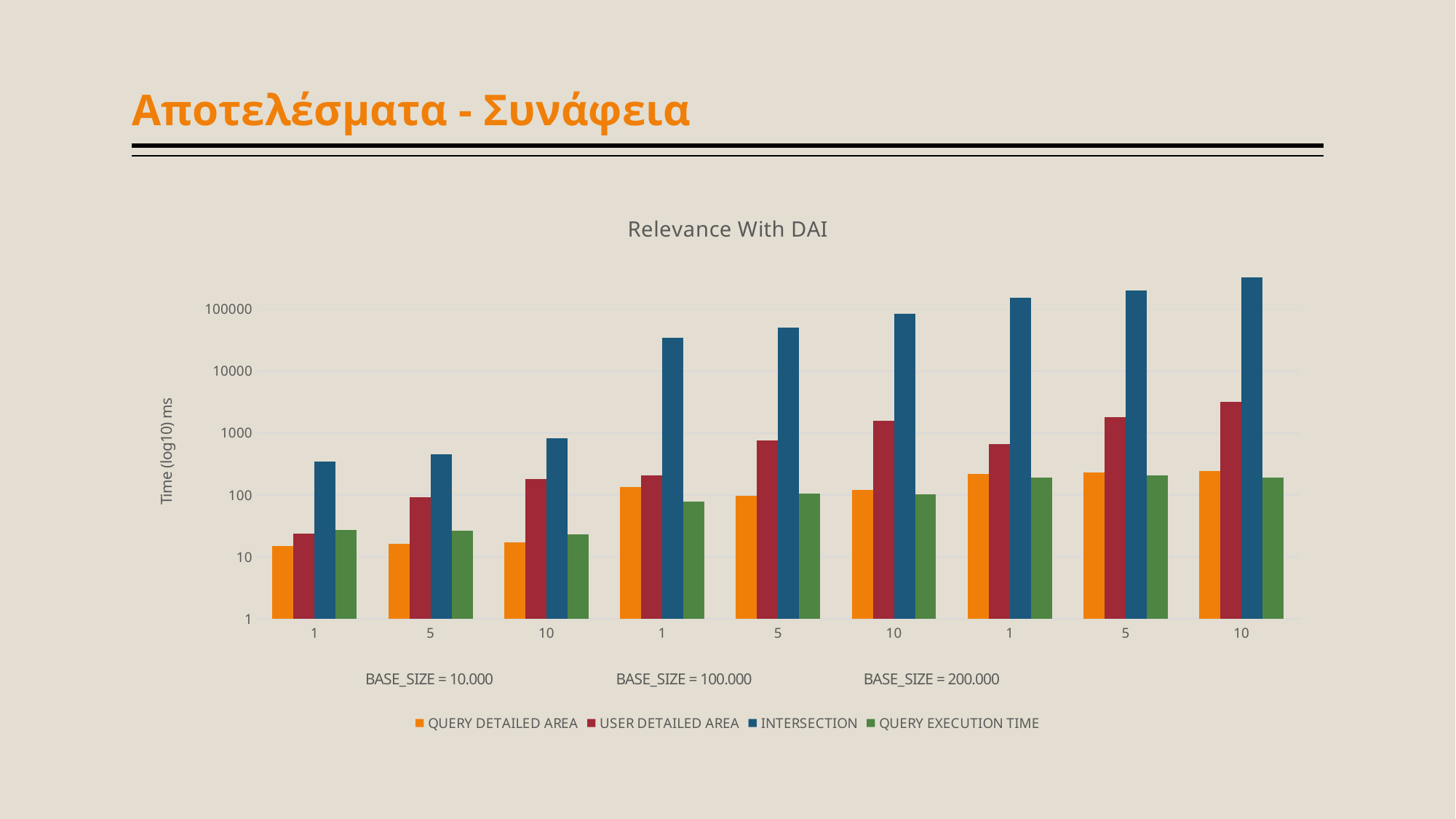
Is the value for USER DETAILED AREA at 10 under BASE_SIZE = 200.000 greater or less than 1000? greater Which is larger at 1 under BASE_SIZE = 100.000: INTERSECTION or USER DETAILED AREA? INTERSECTION How many series does the legend list? 4 What is the title of the chart? Relevance With DAI Is the value for INTERSECTION at 1 under BASE_SIZE = 10.000 greater or less than 1000? less Which series has the lowest bar in the group for 1 under BASE_SIZE = 10.000? QUERY DETAILED AREA What kind of chart is shown on the slide? bar chart What is the label of the vertical axis? Time (log10) ms How many groups of bars are plotted along the x axis? 9 Do the INTERSECTION values rise or fall from left to right across the groups? rise Which series has the tallest bar in every group? INTERSECTION Is the value for INTERSECTION at 10 under BASE_SIZE = 200.000 greater or less than 100000? greater